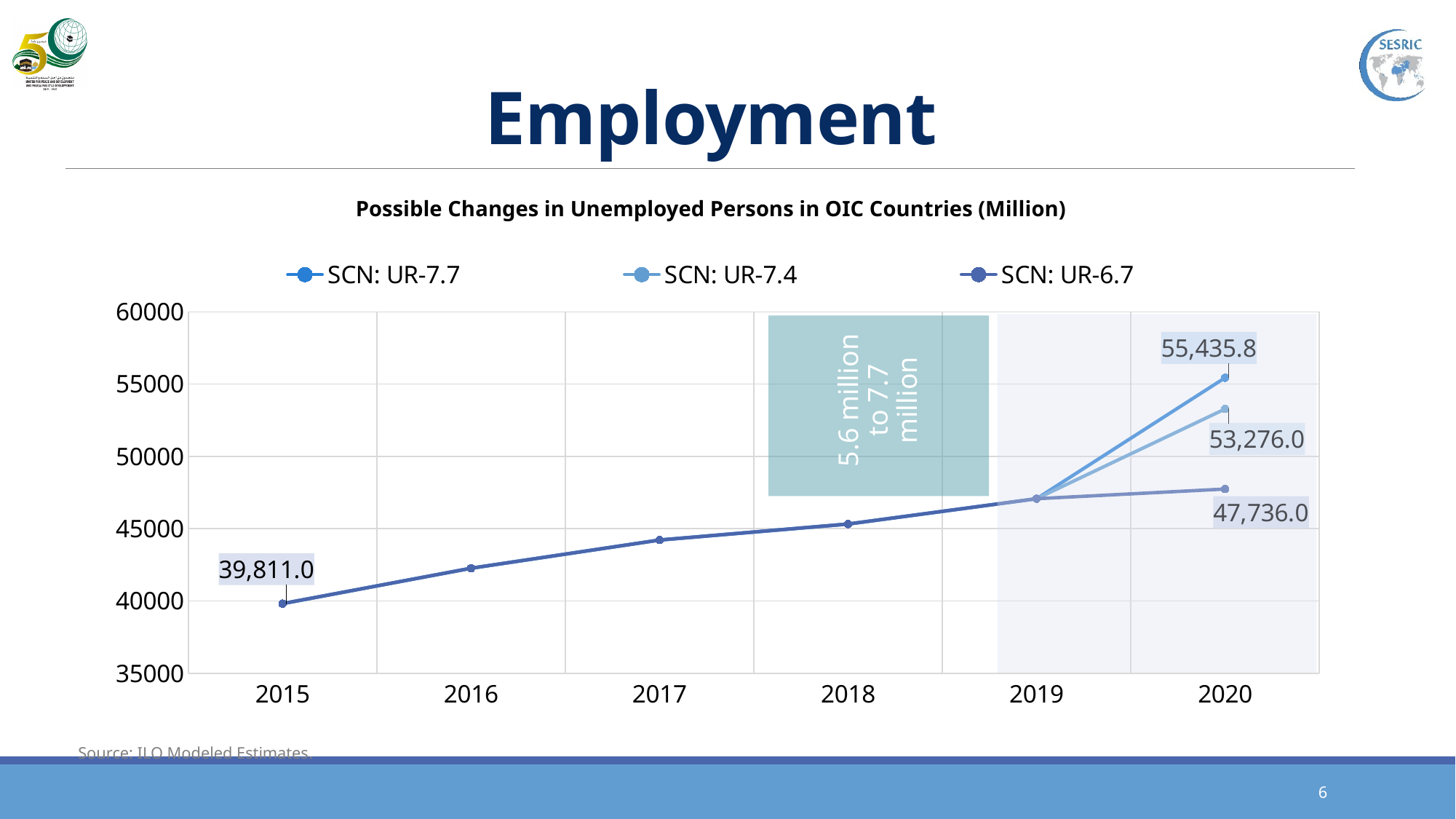
What kind of chart is shown on the slide? line chart What is the value for 2015? 39,811.0 What is the value for SCN: UR-6.7 in 2020? 47,736.0 Which series has the lowest value in 2020? SCN: UR-6.7 What is the value for SCN: UR-7.7 in 2020? 55,435.8 How many series does the legend list? 3 Which series has the highest value in 2020? SCN: UR-7.7 How many years are shown on the x axis? 6 What is the title of the chart? Possible Changes in Unemployed Persons in OIC Countries (Million) What is the value for SCN: UR-7.4 in 2020? 53,276.0 Is the value for 2019 greater or less than 45000? greater What is the difference between the SCN: UR-7.7 and SCN: UR-6.7 values in 2020? 7,699.8